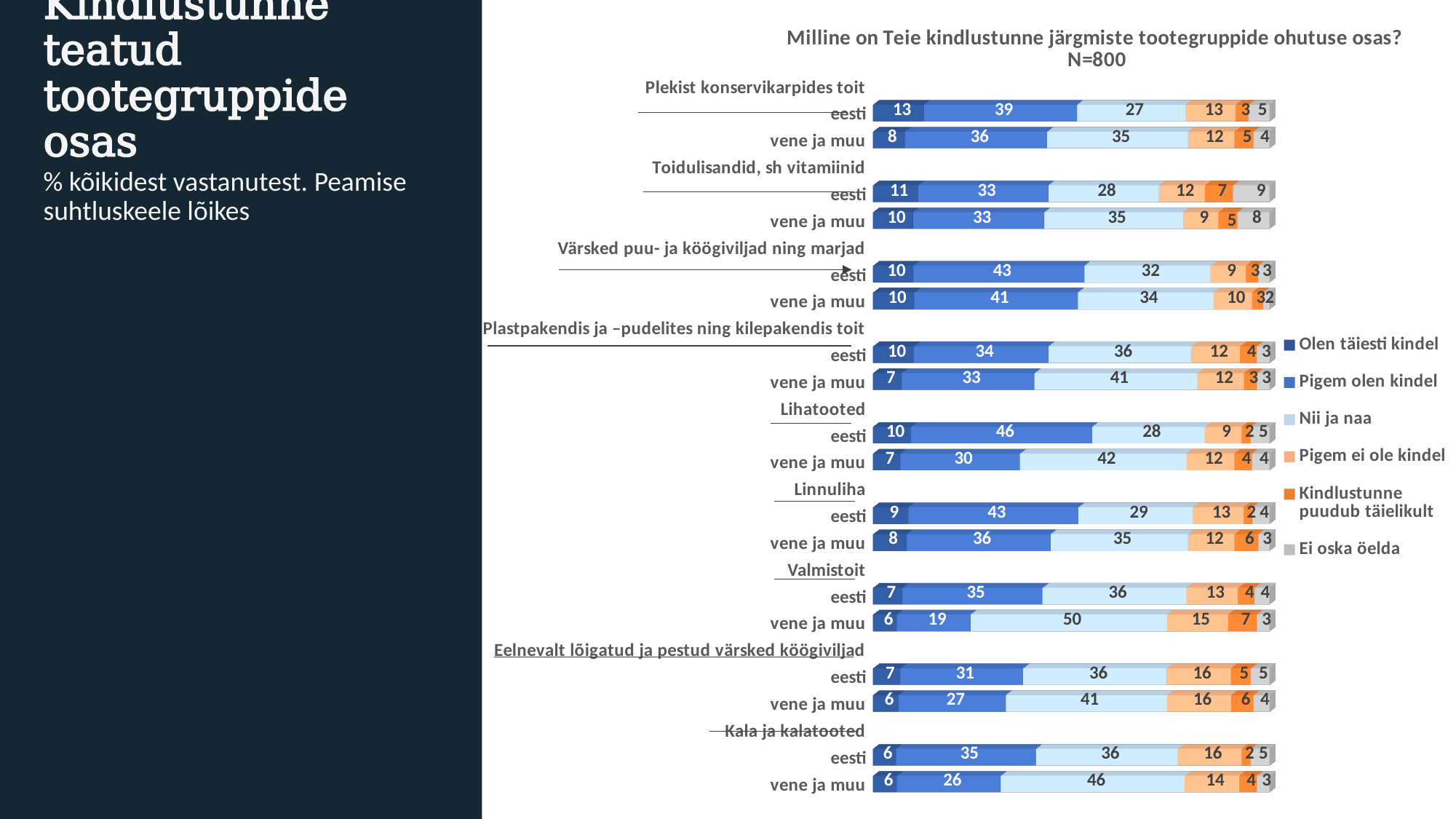
What is the value of 'Nii ja naa' for 'Valmistoit' among 'vene ja muu' respondents? 50 How many product groups are shown in the chart? 9 What is the value of 'Ei oska öelda' for 'Toidulisandid, sh vitamiinid' among 'eesti' respondents? 9 What kind of chart is shown on the slide? Stacked bar chart Which row has the highest value for 'Pigem olen kindel'? Lihatooted, eesti For 'Valmistoit', which group has the larger 'Nii ja naa' value, 'eesti' or 'vene ja muu'? vene ja muu What sample size (N) is stated in the chart title? N=800 What is the total of the stacked bar for 'Plekist konservikarpides toit', 'eesti'? 100 How many series does the legend list? 6 What is the difference in 'Pigem olen kindel' between 'eesti' and 'vene ja muu' for 'Lihatooted'? 16 What is the value of 'Kindlustunne puudub täielikult' for 'Toidulisandid, sh vitamiinid' among 'eesti' respondents? 7 What is the value of 'Olen täiesti kindel' for 'Plekist konservikarpides toit' among 'eesti' respondents? 13